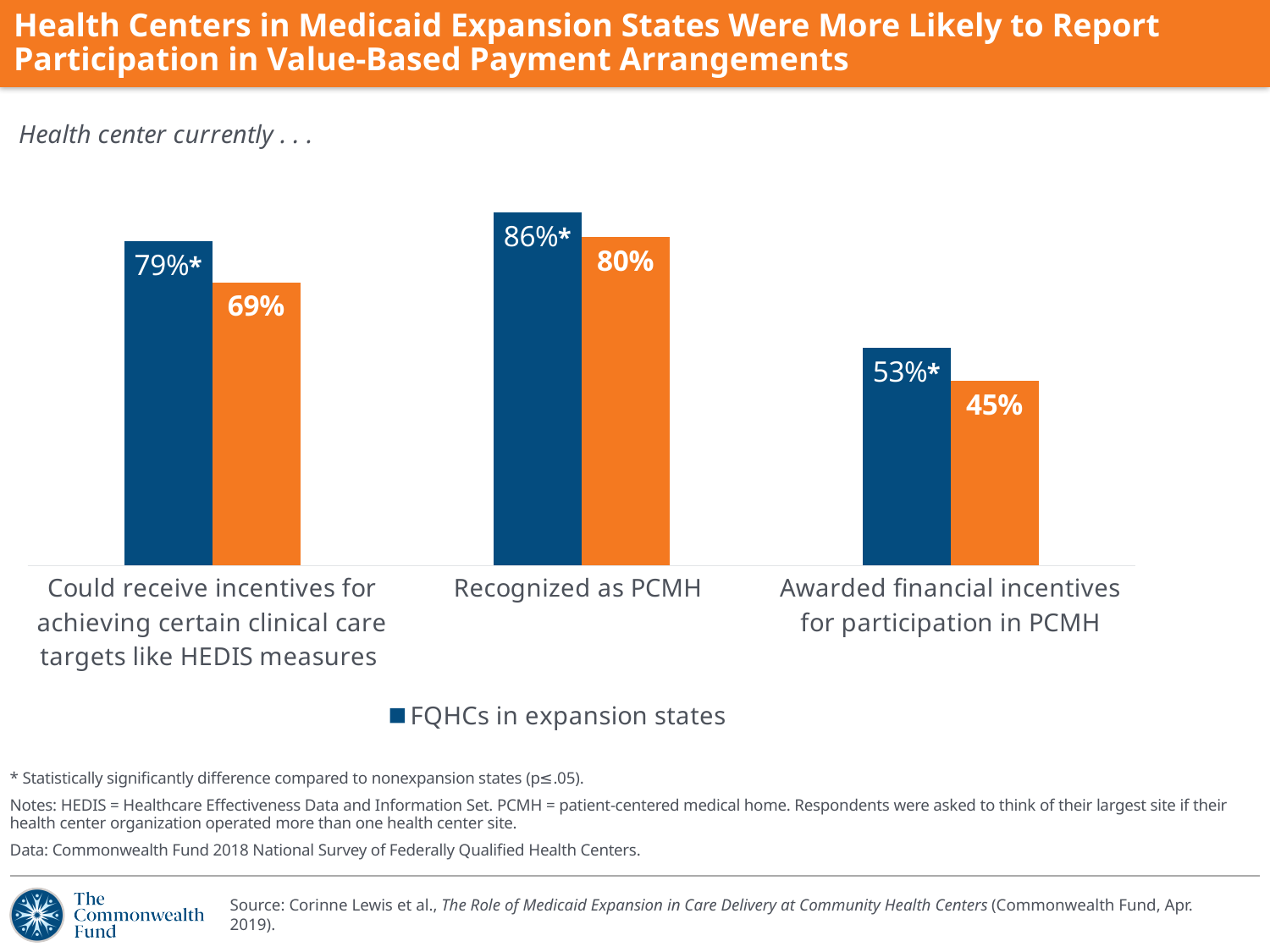
For FQHCs in expansion states, which category has the highest value? Recognized as PCMH For FQHCs in expansion states, which category has the lowest value? Awarded financial incentives for participation in PCMH How many categories are shown on the x axis of the chart? 3 What percentage of FQHCs in expansion states are recognized as PCMH? 86% What percentage of FQHCs in expansion states could receive incentives for achieving certain clinical care targets like HEDIS measures? 79% What value is shown on the orange bar for 'Recognized as PCMH'? 80% For 'Recognized as PCMH', what is the difference between the blue bar (FQHCs in expansion states) and the orange bar? 6 percentage points What kind of chart is shown on the slide? Bar chart For 'Awarded financial incentives for participation in PCMH', which bar is larger, the blue bar for FQHCs in expansion states or the orange bar? The blue bar (FQHCs in expansion states) How many series does the legend list? 1 For 'Could receive incentives for achieving certain clinical care targets like HEDIS measures', how much higher is the blue bar than the orange bar? 10 percentage points What value is shown on the orange bar for 'Awarded financial incentives for participation in PCMH'? 45%